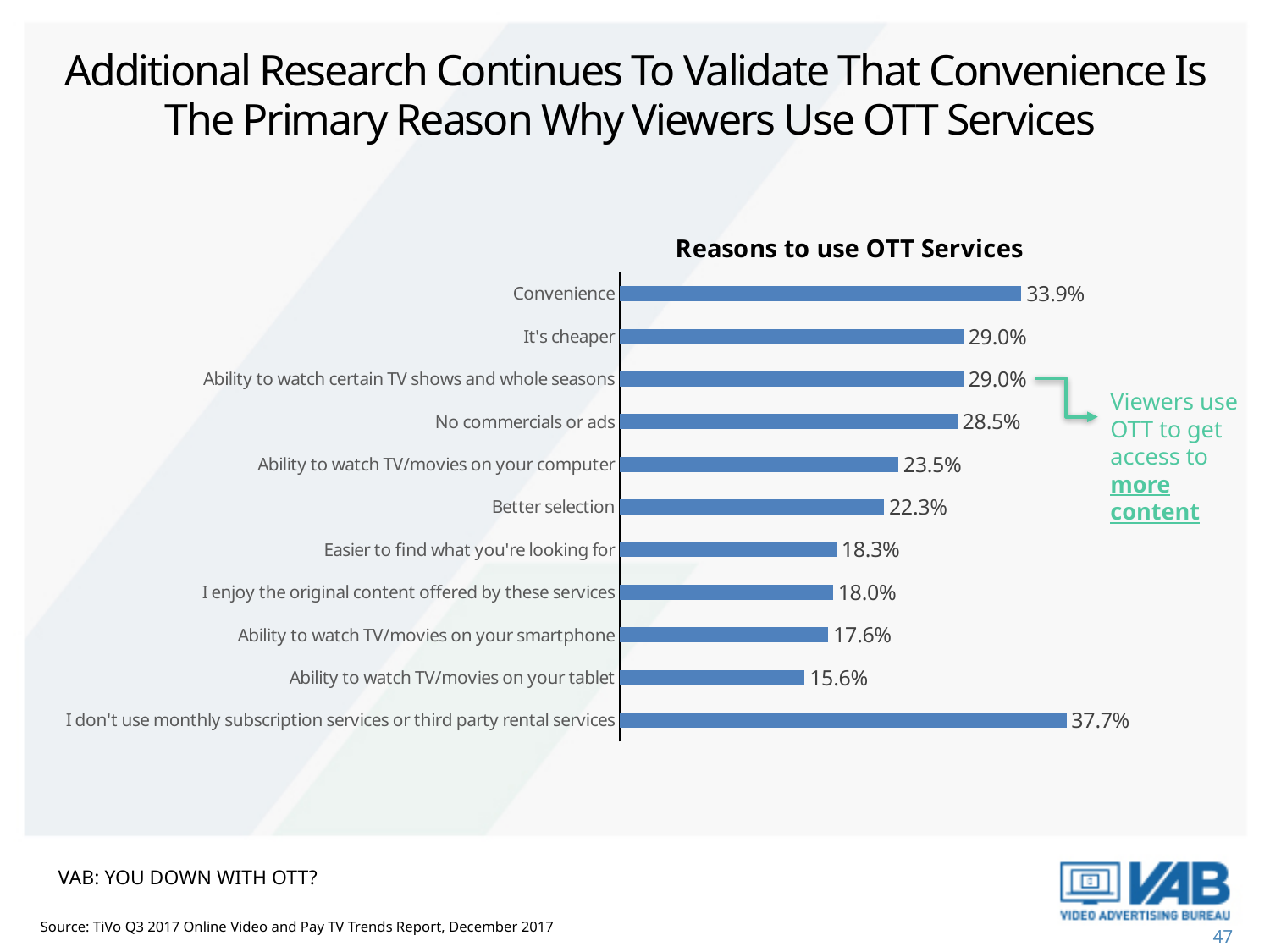
Which category has the lowest value? Ability to watch TV/movies on your tablet How many categories are shown in the chart? 11 What kind of chart is shown on the slide? Bar chart What is the value for I enjoy the original content offered by these services? 18.0% What is the value for Convenience? 33.9% What is the value for Ability to watch TV/movies on your tablet? 15.6% What is the difference between the values for Ability to watch TV/movies on your computer and Ability to watch TV/movies on your smartphone? 5.9% What is the difference between the values for Convenience and It's cheaper? 4.9% Which category has the highest value? I don't use monthly subscription services or third party rental services What is the title of the chart? Reasons to use OTT Services What is the value for No commercials or ads? 28.5% Which is larger, the value for Better selection or the value for Easier to find what you're looking for? Better selection